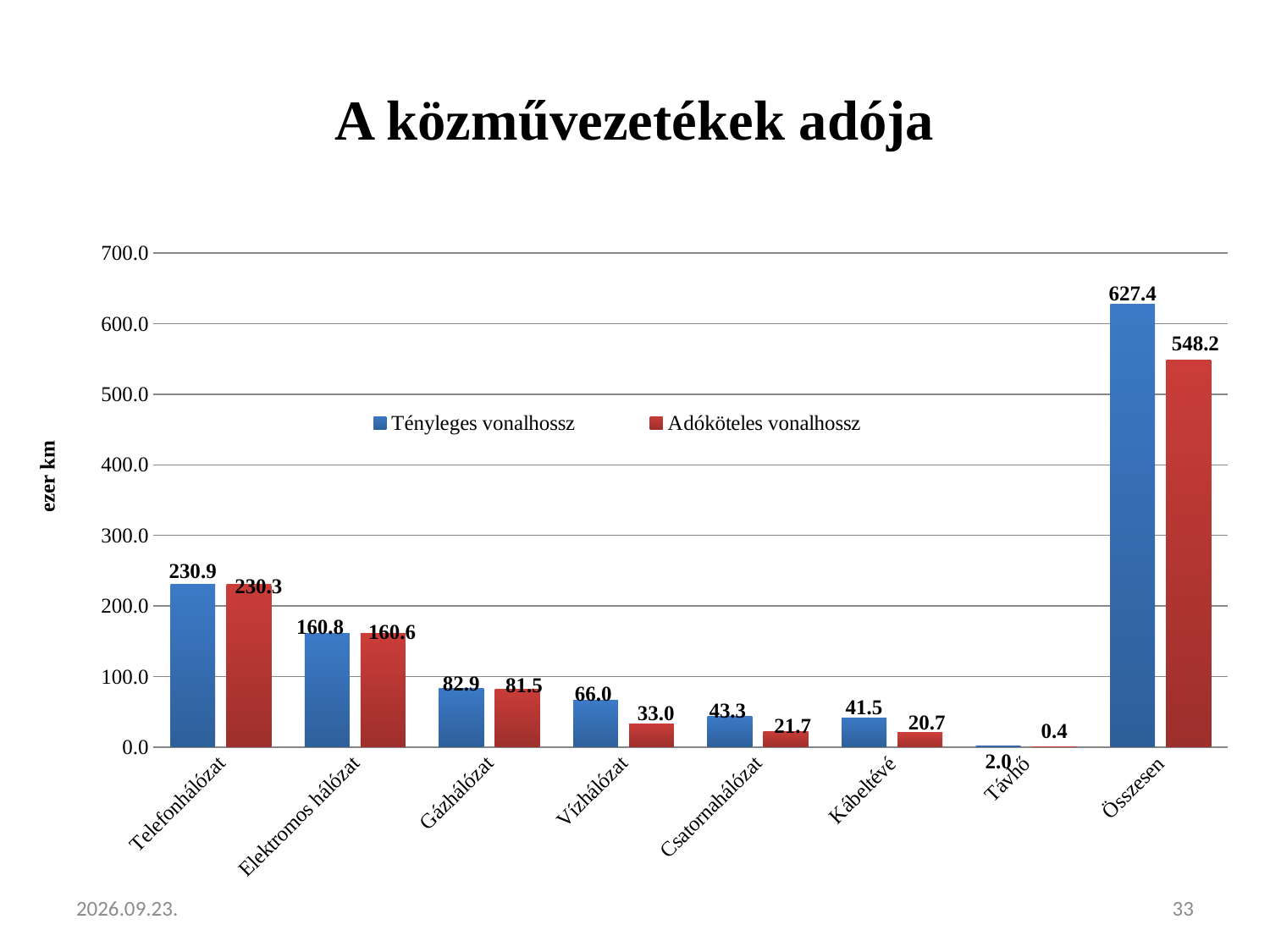
What is the Adóköteles vonalhossz value for Összesen? 548.2 What is the Tényleges vonalhossz value for Kábeltévé? 41.5 Which is larger: the Adóköteles vonalhossz for Csatornahálózat or for Kábeltévé? Csatornahálózat What is the difference between the Tényleges vonalhossz and Adóköteles vonalhossz for Vízhálózat? 33.0 What is the Adóköteles vonalhossz value for Vízhálózat? 33.0 How many series does the legend list? 2 What is the Tényleges vonalhossz value for Telefonhálózat? 230.9 Which category has the lowest Adóköteles vonalhossz? Távhő Excluding Összesen, which category has the highest Tényleges vonalhossz? Telefonhálózat What kind of chart is shown on the slide? Bar chart What is the difference between the Tényleges vonalhossz and Adóköteles vonalhossz for Összesen? 79.2 How many categories are shown on the x axis? 8